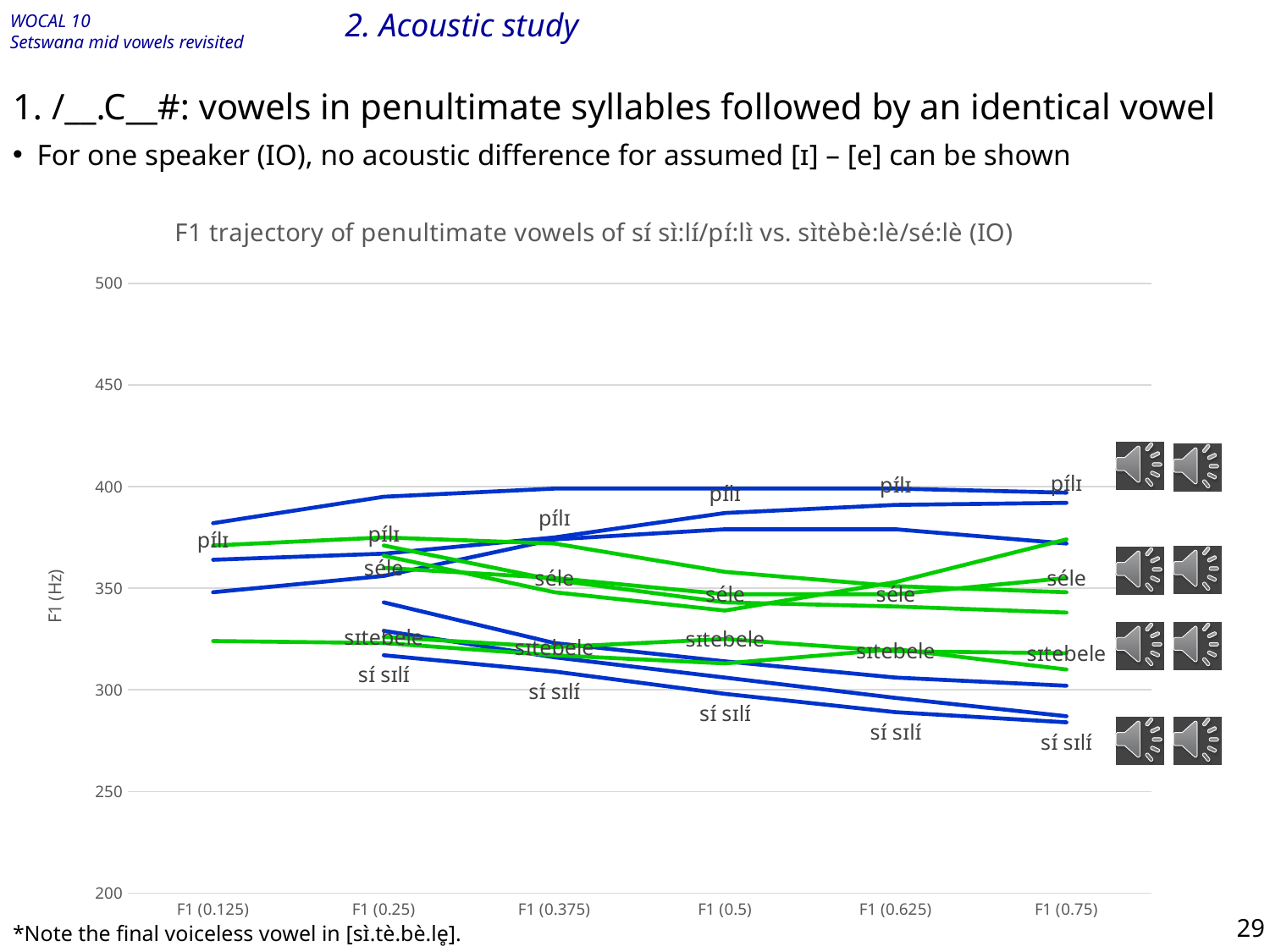
How many time points are shown along the x axis of the chart? 6 At F1 (0.75), which is higher: the píli lines or the sí sɪlí lines? píli Is the value for sɪtebele at F1 (0.125) greater or less than 300? greater What is the lowest value shown on the vertical axis of the chart? 200 What kind of chart is shown on the slide? Line chart What is the title of the chart? F1 trajectory of penultimate vowels of sí sì:lí/pí:lì vs. sìtèbè:lè/sé:lè (IO) Do the sí sɪlí lines rise or fall from F1 (0.25) to F1 (0.75)? fall What is the label on the vertical axis of the chart? F1 (Hz) Is the value for sɪtebele at F1 (0.125) greater or less than 350? less Is the value for séle at F1 (0.5) greater or less than 400? less What is the highest value shown on the vertical axis of the chart? 500